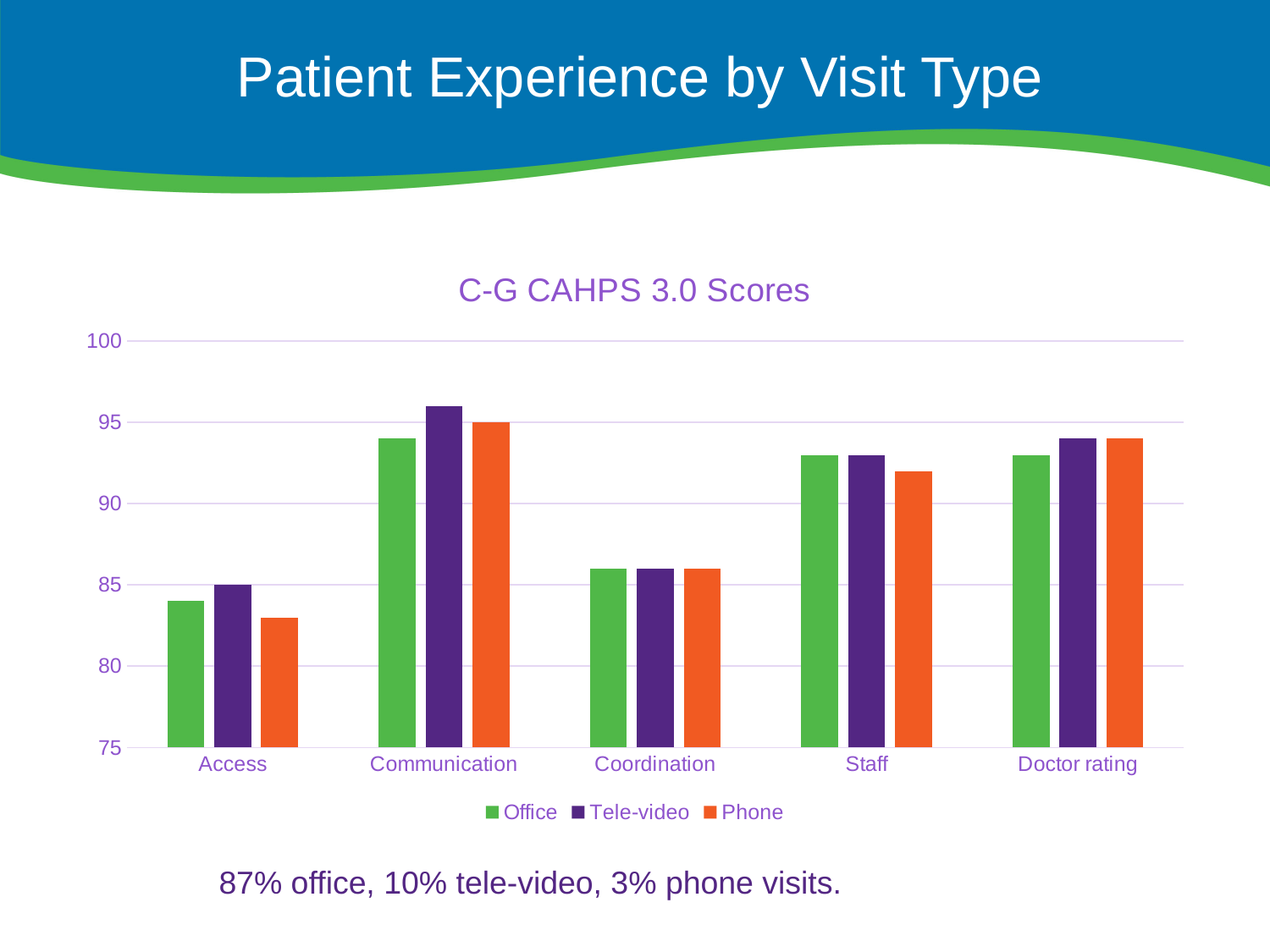
Which category has the lowest Phone score? Access What is the Tele-video score for Access? 85 What is the title of the chart? C-G CAHPS 3.0 Scores What is the Phone score for Communication? 95 Is the Phone score for Staff greater or less than 90? greater Is the Office score for Access greater or less than 85? less Which category has the highest Tele-video score? Communication Is the Tele-video score for Communication greater or less than 95? greater For Access, which is larger: the Tele-video score or the Phone score? Tele-video How many series does the legend list? 3 What type of chart is shown on the slide? bar chart How many categories are shown on the x axis? 5